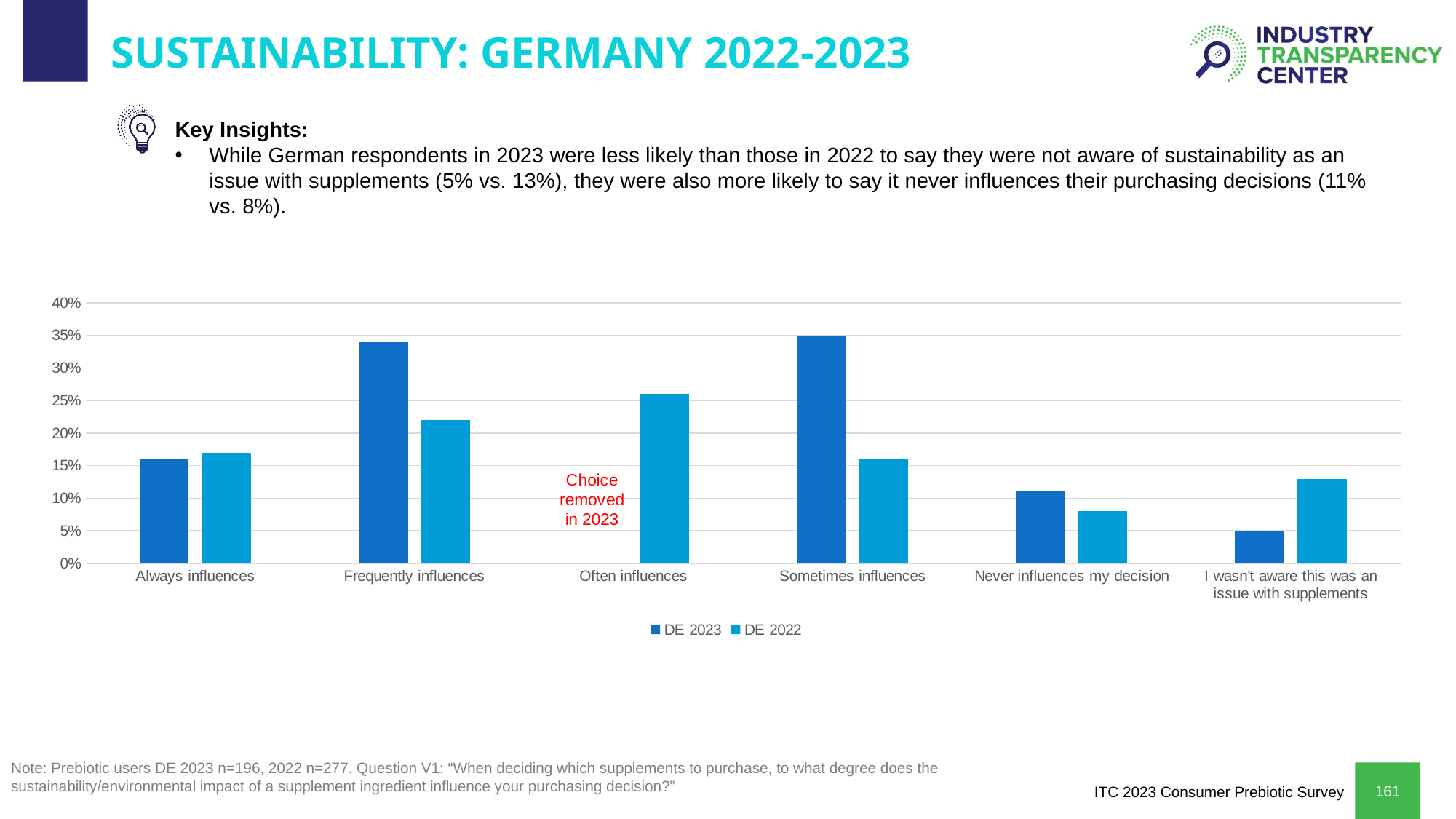
Is the DE 2022 value for Sometimes influences greater or less than 20%? less Is the DE 2023 value for Frequently influences greater or less than 30%? greater How many categories are shown along the x axis? 6 What kind of chart is shown on the slide? bar chart For Sometimes influences, which series has the larger value, DE 2023 or DE 2022? DE 2023 Which category has the highest value for DE 2022? Often influences Which category has the lowest value for DE 2023? I wasn't aware this was an issue with supplements What are the two series named in the legend? DE 2023 and DE 2022 How many series does the legend list? 2 For I wasn't aware this was an issue with supplements, which series has the larger value, DE 2023 or DE 2022? DE 2022 Which category has the lowest value for DE 2022? Never influences my decision Which category has no DE 2023 bar because the choice was removed in 2023? Often influences